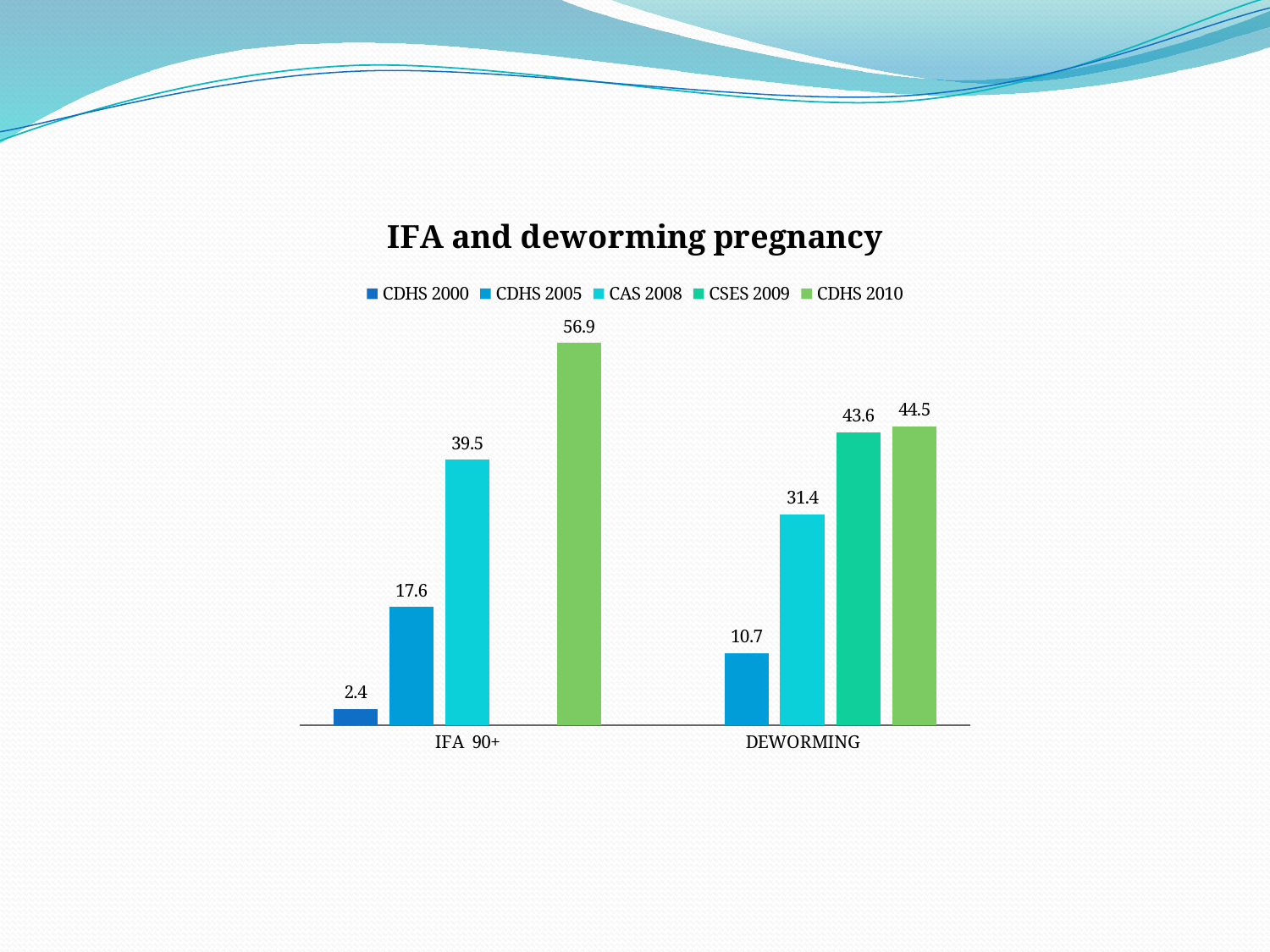
What is the difference between the CDHS 2010 and CAS 2008 values in the IFA 90+ category? 17.4 Do the values for IFA 90+ rise or fall from CDHS 2000 to CDHS 2010? rise What is the value for CDHS 2010 in the IFA 90+ category? 56.9 What is the value for CAS 2008 in the IFA 90+ category? 39.5 How many series does the legend list? 5 Which series has the lowest value in the IFA 90+ category? CDHS 2000 What kind of chart is shown on the slide? bar chart How many categories are shown on the x axis? 2 Which series has the highest value in the DEWORMING category? CDHS 2010 What is the value for CDHS 2005 in the DEWORMING category? 10.7 Which is larger: the CAS 2008 value for IFA 90+ or the CAS 2008 value for DEWORMING? IFA 90+ What is the title of the chart? IFA and deworming pregnancy